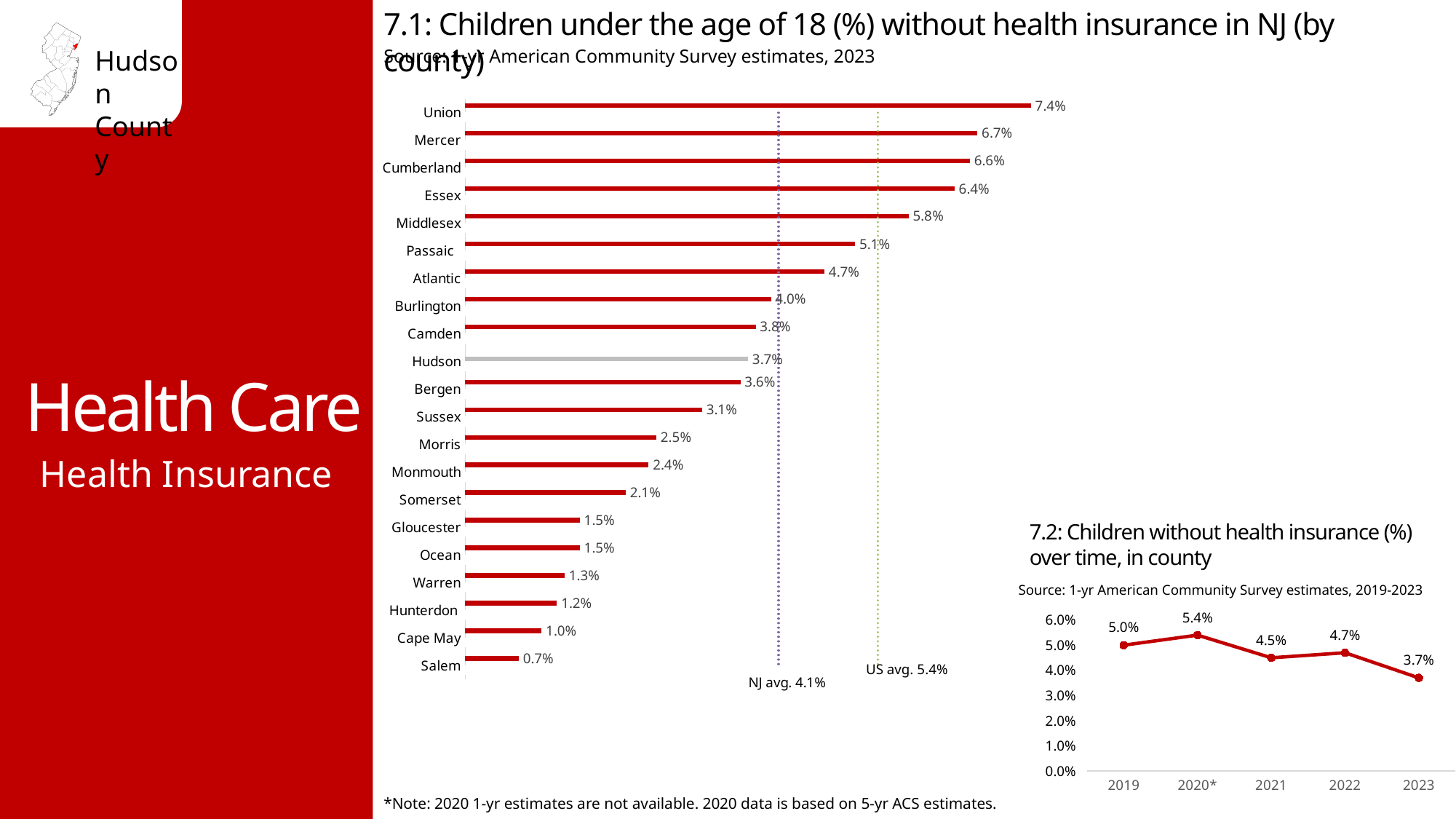
In chart 7.1, how many counties are shown? 21 In chart 7.1 (children under 18 without health insurance by county), what is the value for Hudson? 3.7% In chart 7.1, which county has the highest percentage of children without health insurance? Union In chart 7.1, what is the value for Passaic? 5.1% In chart 7.1, what NJ average value is marked by the dotted reference line? 4.1% In chart 7.1, what is the difference between the values for Union and Salem? 6.7% In chart 7.1, which county has the lowest percentage of children without health insurance? Salem What kind of chart is chart 7.1? Bar chart In chart 7.2, which year has the highest value? 2020* In chart 7.1, which county has a larger value, Essex or Middlesex? Essex In chart 7.2, what is the difference between the 2019 and 2023 values? 1.3% In chart 7.2 (children without health insurance over time in county), what is the value for 2021? 4.5%